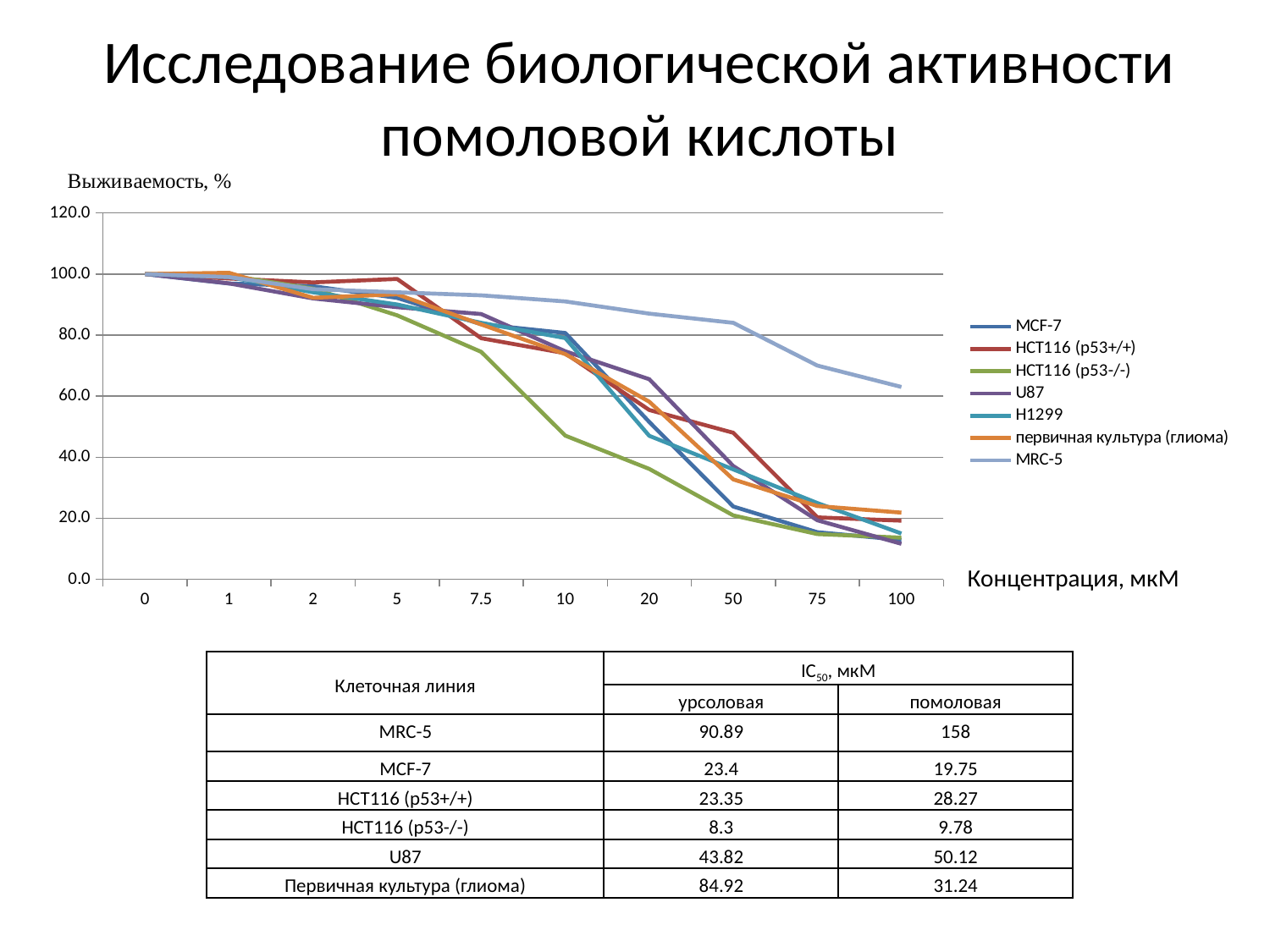
At concentration 50, which series has the larger value: HCT116 (p53+/+) or MCF-7? HCT116 (p53+/+) What is the label of the horizontal axis of the chart? Концентрация, мкМ Which series has the lowest survival value at concentration 10? HCT116 (p53-/-) How many concentration points are plotted along the x axis of the chart? 10 How many series does the chart legend list? 7 At concentration 20, which series has the larger value: MRC-5 or HCT116 (p53-/-)? MRC-5 Is the value for MRC-5 at concentration 100 greater or less than 40? greater Is the value for HCT116 (p53-/-) at concentration 10 greater or less than 60? less What kind of chart is shown on the slide? line chart What is the label of the vertical axis of the chart? Выживаемость, % Which series has the highest survival value at concentration 100? MRC-5 Do the survival values rise or fall as the concentration increases along the x axis? fall